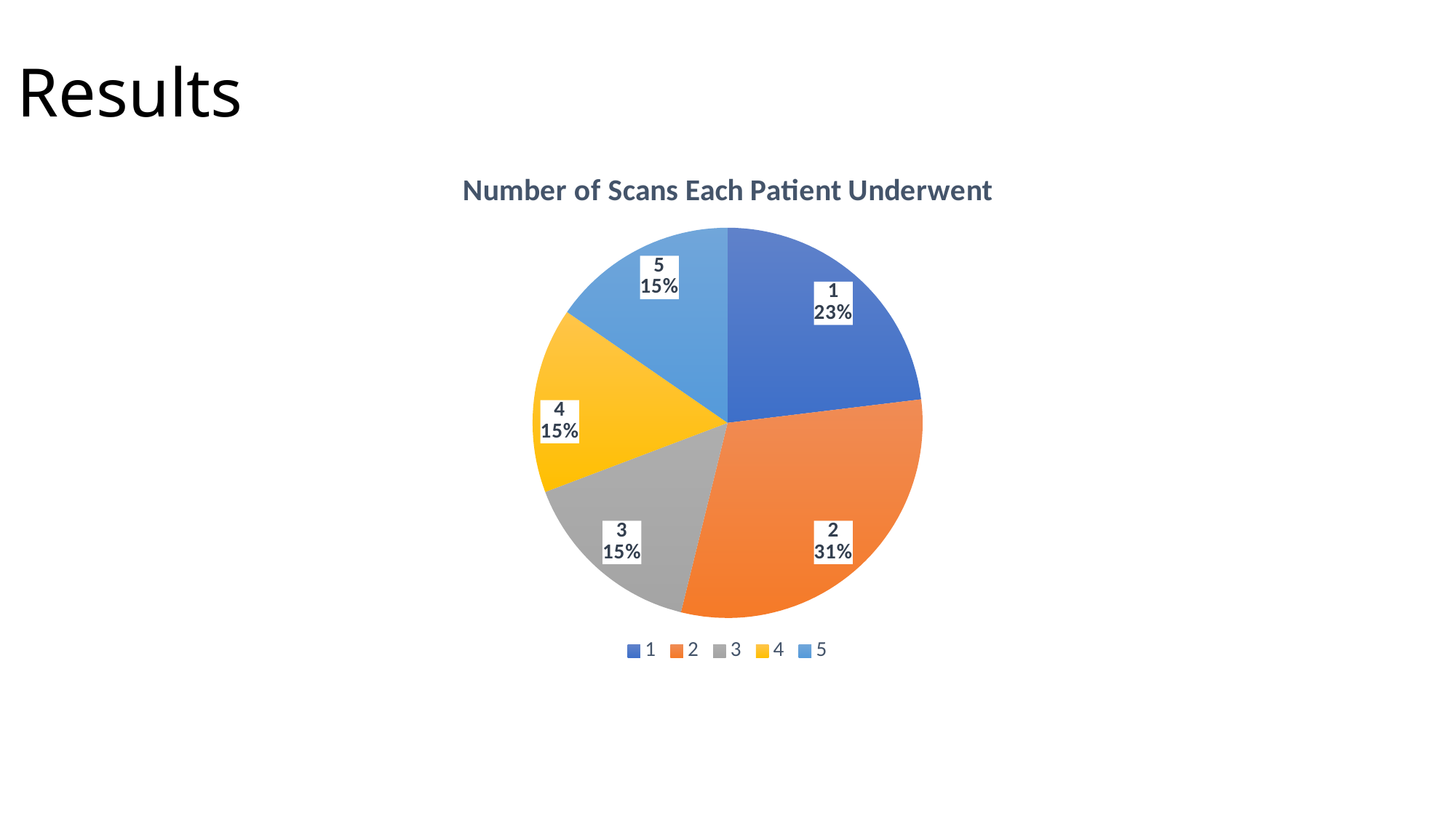
What share of the pie does category 5 represent? 15% What is the title of the chart? Number of Scans Each Patient Underwent What share of the pie does category 3 represent? 15% What share of the pie does category 1 represent? 23% What is the difference in percentage points between the slices for category 2 and category 1? 8 Which slice is larger, category 1 or category 4? 1 How many entries does the legend list? 5 What colour is the slice for category 4? yellow What type of chart is shown on the slide? pie chart Which category has the largest slice of the pie? 2 How many slices does the pie chart have? 5